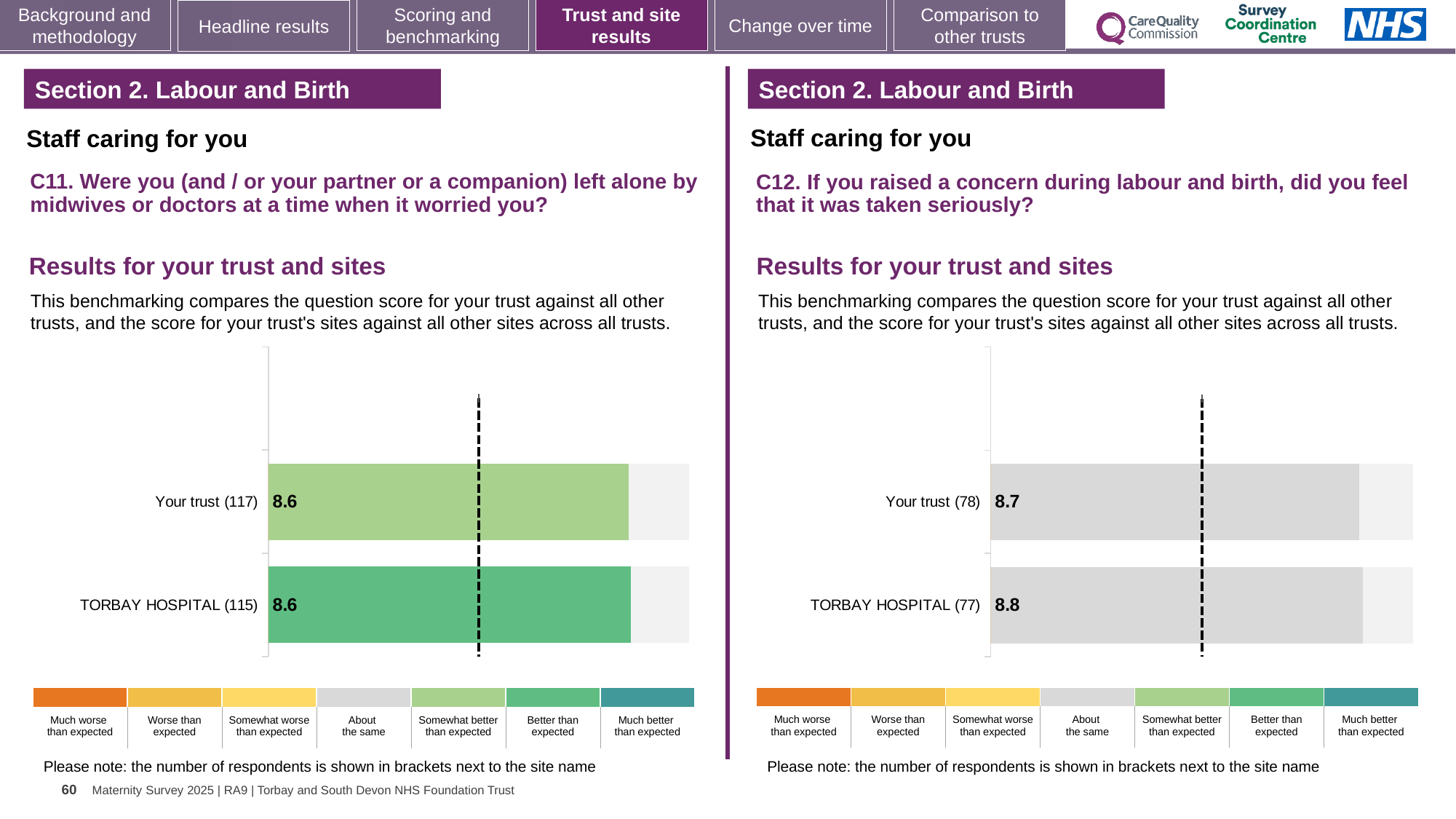
What type of chart is used for the C12 results on the right? Bar chart In the C12 chart on the right, what is the score for TORBAY HOSPITAL? 8.8 In the C12 chart on the right, which category has the lowest score? Your trust In the C11 chart on the left, what is the score for Your trust? 8.6 In the C12 chart on the right, which benchmarking category does the grey colour of the bars represent? About the same In the C12 chart on the right, what is the difference between the TORBAY HOSPITAL score and the Your trust score? 0.1 How many bars are shown in the C11 chart on the left? 2 How many benchmarking categories are listed in the colour key below the C11 chart on the left? 7 In the C11 chart on the left, what is the score for TORBAY HOSPITAL? 8.6 In the C12 chart on the right, what is the score for Your trust? 8.7 In the C11 chart on the left, is the score for Your trust greater or less than 8? greater In the C12 chart on the right, which has the higher score, Your trust or TORBAY HOSPITAL? TORBAY HOSPITAL